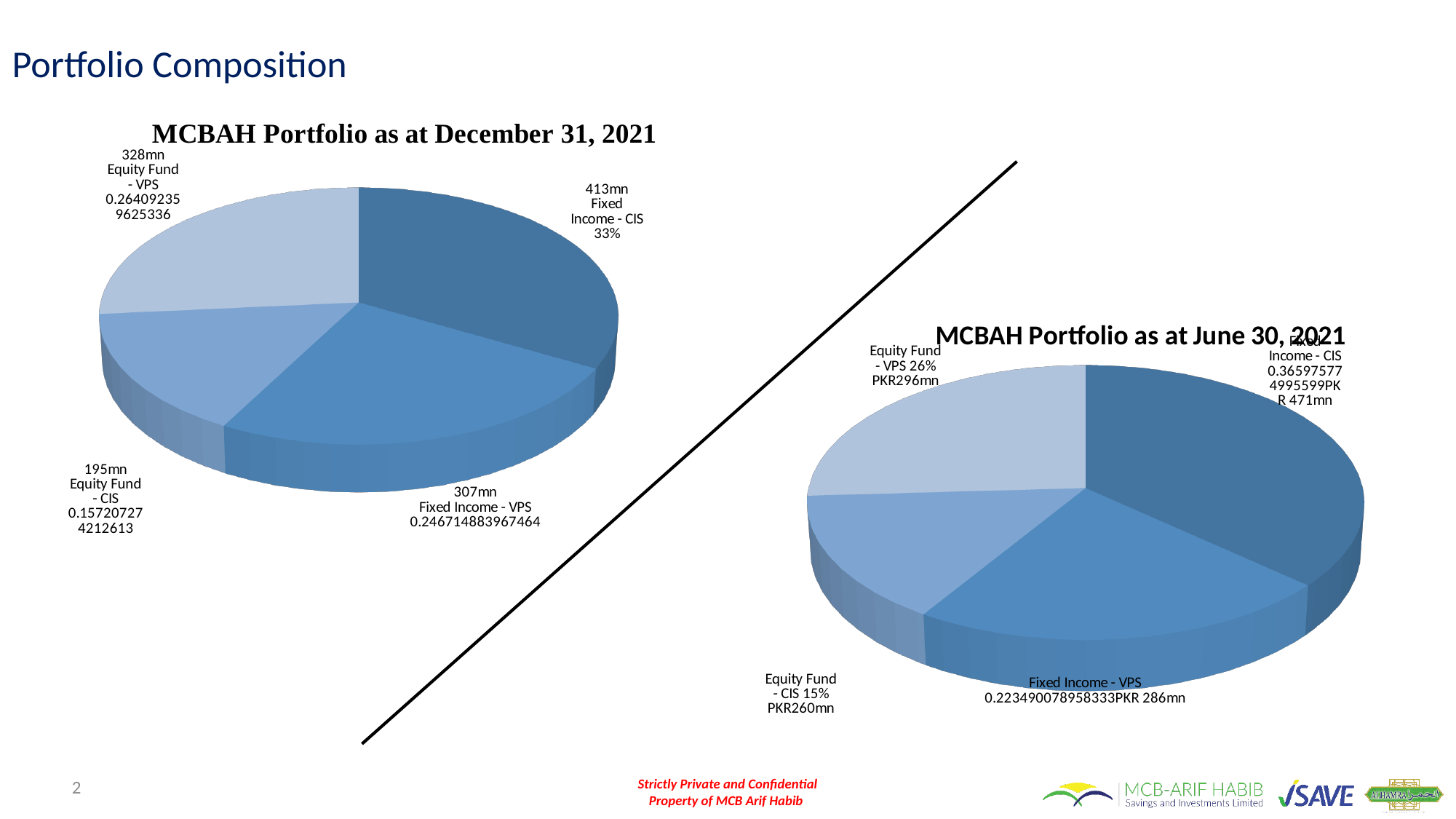
In the MCBAH Portfolio as at December 31, 2021 chart, what share of the portfolio is Fixed Income - CIS? 33% How many slices does the MCBAH Portfolio as at June 30, 2021 pie chart have? 4 In the MCBAH Portfolio as at December 31, 2021 chart, what is the difference between Fixed Income - CIS and Fixed Income - VPS? 106mn In the MCBAH Portfolio as at June 30, 2021 chart, what is the value for Equity Fund - CIS? PKR260mn In the MCBAH Portfolio as at December 31, 2021 chart, which category has the largest slice? Fixed Income - CIS In the MCBAH Portfolio as at June 30, 2021 chart, which is larger, Equity Fund - VPS or Fixed Income - VPS? Equity Fund - VPS In the MCBAH Portfolio as at December 31, 2021 chart, what is the value for Fixed Income - CIS? 413mn In the MCBAH Portfolio as at June 30, 2021 chart, what share of the portfolio is Equity Fund - VPS? 26% In the MCBAH Portfolio as at December 31, 2021 chart, which category has the smallest slice? Equity Fund - CIS In the MCBAH Portfolio as at June 30, 2021 chart, what is the value for Fixed Income - VPS? PKR 286mn What type of chart is used for the MCBAH Portfolio as at December 31, 2021? Pie chart In the MCBAH Portfolio as at December 31, 2021 chart, what is the value for Equity Fund - CIS? 195mn